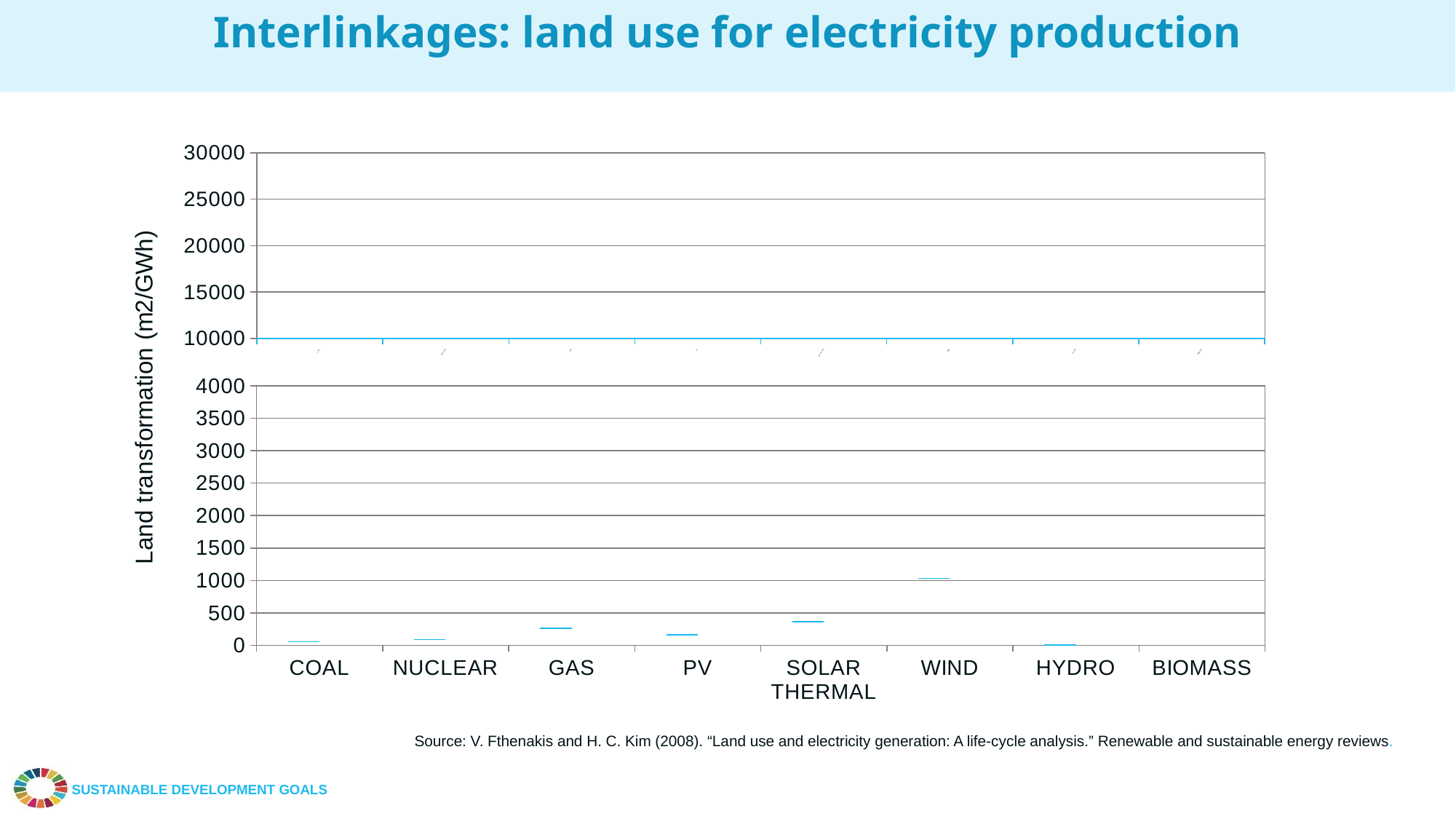
How many categories are shown on the x axis of the chart? 8 Is the value for GAS greater or less than 500? less Which has the larger value, SOLAR THERMAL or GAS? SOLAR THERMAL What is the label of the y axis of the chart? Land transformation (m2/GWh) Is the value for WIND greater or less than 500? greater What is the title of the slide containing the chart? Interlinkages: land use for electricity production Is the value for SOLAR THERMAL greater or less than 1000? less Which has the larger value, WIND or SOLAR THERMAL? WIND